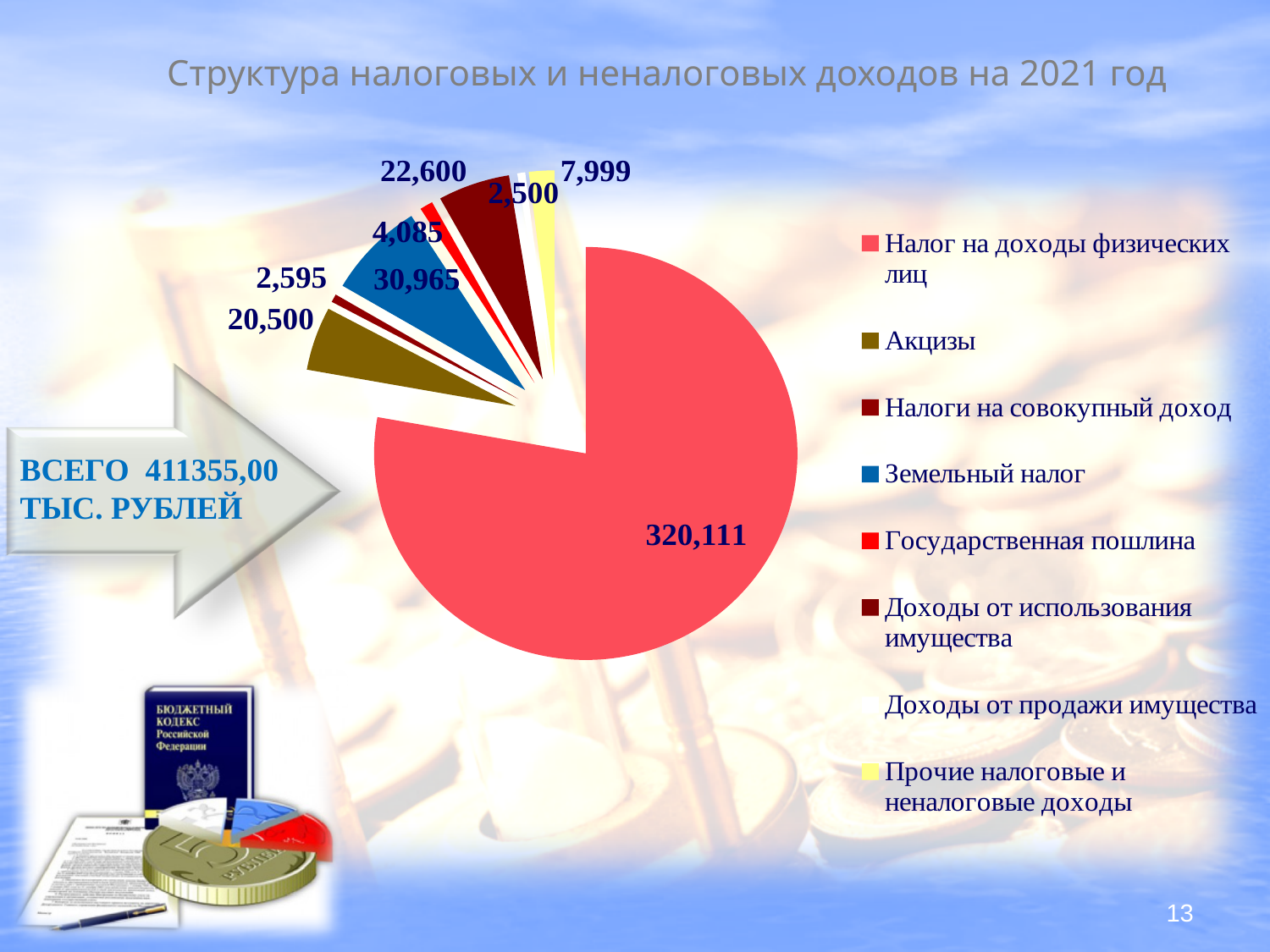
Which category has the smallest value? Доходы от продажи имущества Which is larger, Государственная пошлина or Налоги на совокупный доход? Государственная пошлина What type of chart is shown on the slide? Pie chart What is the value for Доходы от использования имущества? 22,600 How many slices does the pie chart have? 8 Which category has the largest slice of the pie? Налог на доходы физических лиц What is the value for Акцизы? 20,500 What is the difference between Земельный налог and Акцизы? 10,465 What colour is the slice for Земельный налог? Blue What is the value for Налог на доходы физических лиц? 320,111 What is the value for Прочие налоговые и неналоговые доходы? 7,999 What is the value for Земельный налог? 30,965